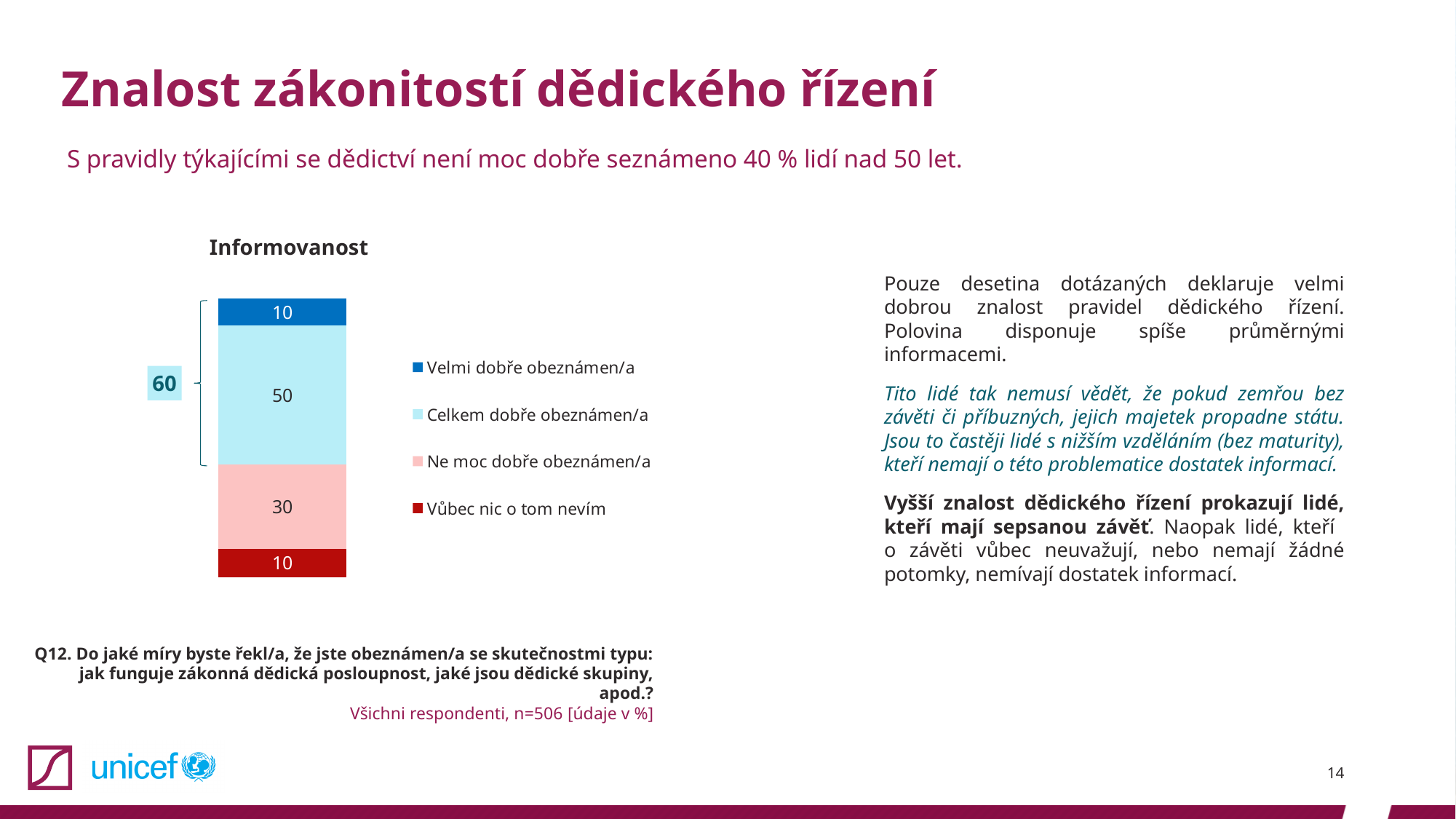
What is the combined value of "Velmi dobře obeznámen/a" and "Celkem dobře obeznámen/a" shown by the bracket next to the Informovanost chart? 60 What colour is the segment for "Vůbec nic o tom nevím" in the Informovanost chart? Dark red What value is shown for "Ne moc dobře obeznámen/a" in the Informovanost chart? 30 What kind of chart is the Informovanost chart? Stacked bar chart What value is shown for "Vůbec nic o tom nevím" in the Informovanost chart? 10 Which category has the highest value in the Informovanost chart? Celkem dobře obeznámen/a Which is larger in the Informovanost chart: "Ne moc dobře obeznámen/a" or "Velmi dobře obeznámen/a"? Ne moc dobře obeznámen/a What value is shown for "Velmi dobře obeznámen/a" in the Informovanost chart? 10 What value is shown for "Celkem dobře obeznámen/a" in the Informovanost chart? 50 What is the difference between the values for "Celkem dobře obeznámen/a" and "Ne moc dobře obeznámen/a" in the Informovanost chart? 20 How many series does the legend of the Informovanost chart list? 4 What is the total of the stacked bar in the Informovanost chart? 100